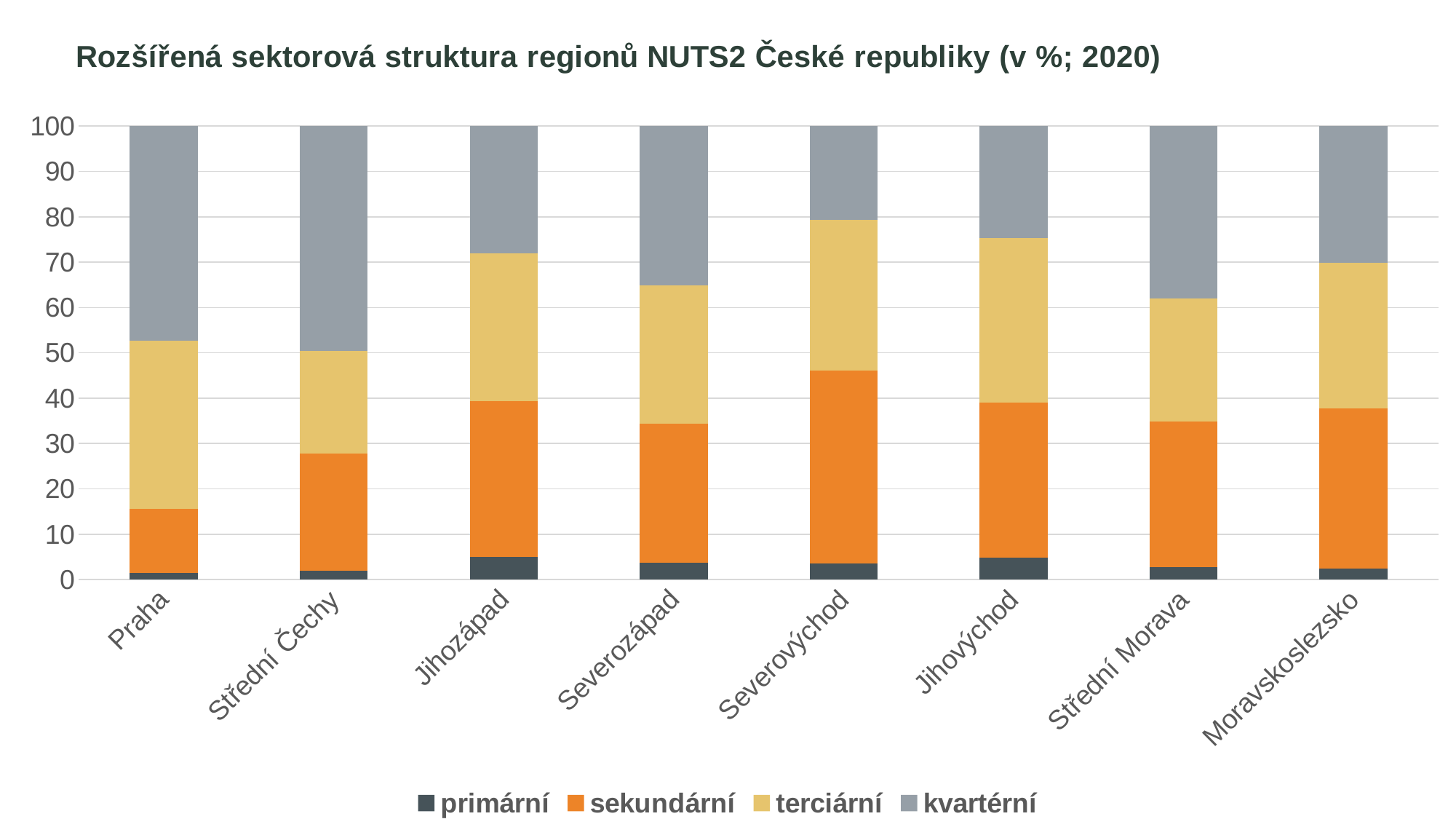
Which region has the largest sekundární (orange) segment? Severovýchod Is the kvartérní value for Praha greater or less than 40? greater What is the total of the stacked bar for Praha? 100 What kind of chart is shown on the slide? Stacked bar chart Which region has the smallest terciární (yellow) segment? Střední Čechy Which region has the smallest sekundární (orange) segment? Praha Which region has the larger kvartérní segment, Praha or Moravskoslezsko? Praha Which region has the smallest kvartérní (grey) segment? Severovýchod How many regions (categories) are shown on the x axis? 8 Is the sekundární value for Praha greater or less than 20? less How many series does the legend list? 4 Is the sekundární value for Severovýchod greater or less than 40? greater